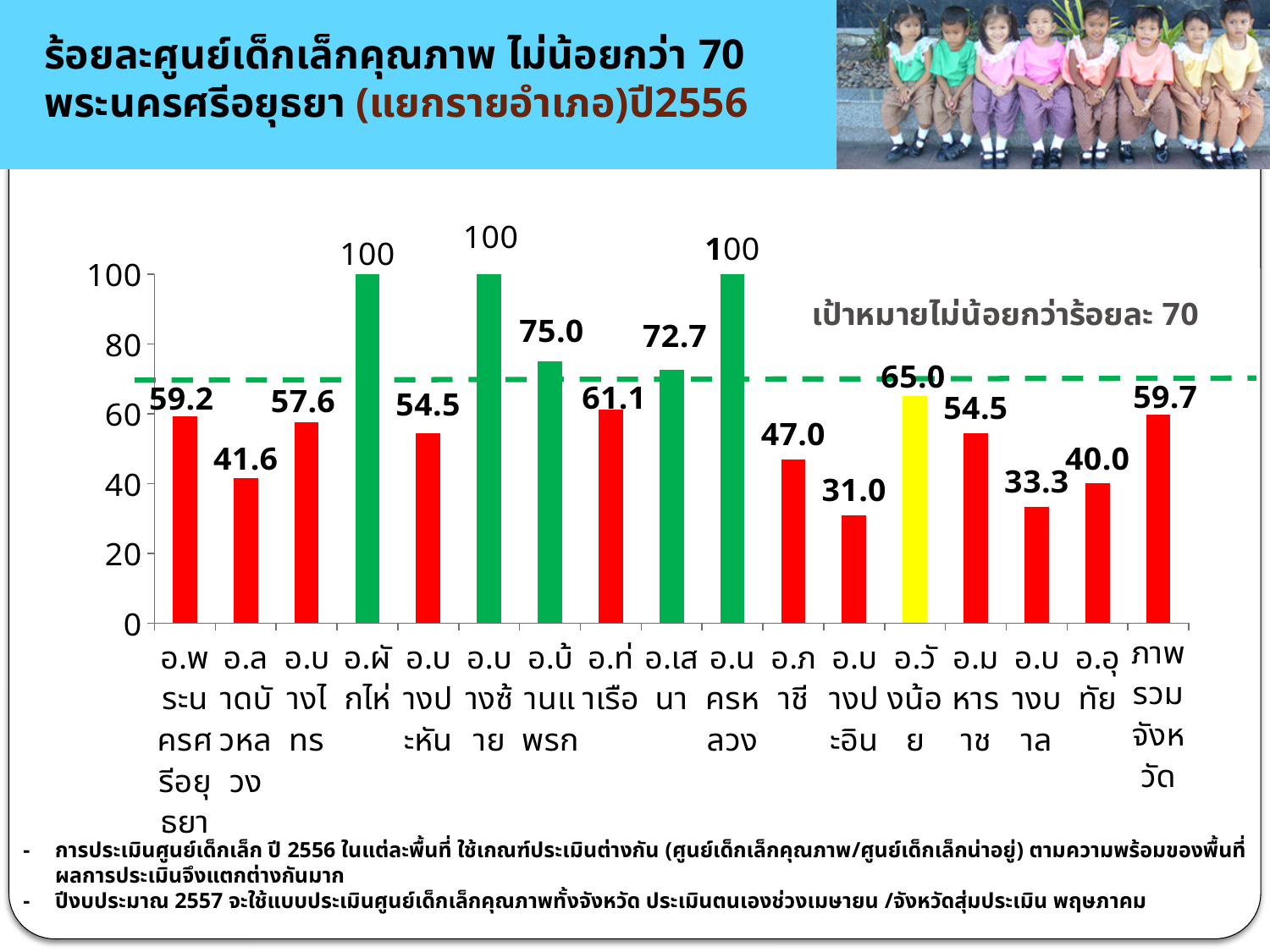
Is the value for อ.เสนา greater or less than 70? greater What target value does the dashed horizontal line represent? 70 Which is larger, the value for อ.ภาชี or the value for อ.อุทัย? อ.ภาชี What is the difference between the values for ภาพรวมจังหวัด and อ.บางปะอิน? 28.7 What is the value for อ.ลาดบัวหลวง? 41.6 What is the value for ภาพรวมจังหวัด? 59.7 What is the difference between the values for อ.บ้านแพรก and อ.ท่าเรือ? 13.9 How many districts have a value of 100? 3 Which district has the lowest value? อ.บางปะอิน What kind of chart is shown on the slide? bar chart How many categories are shown on the x axis? 17 What is the value for อ.วังน้อย? 65.0